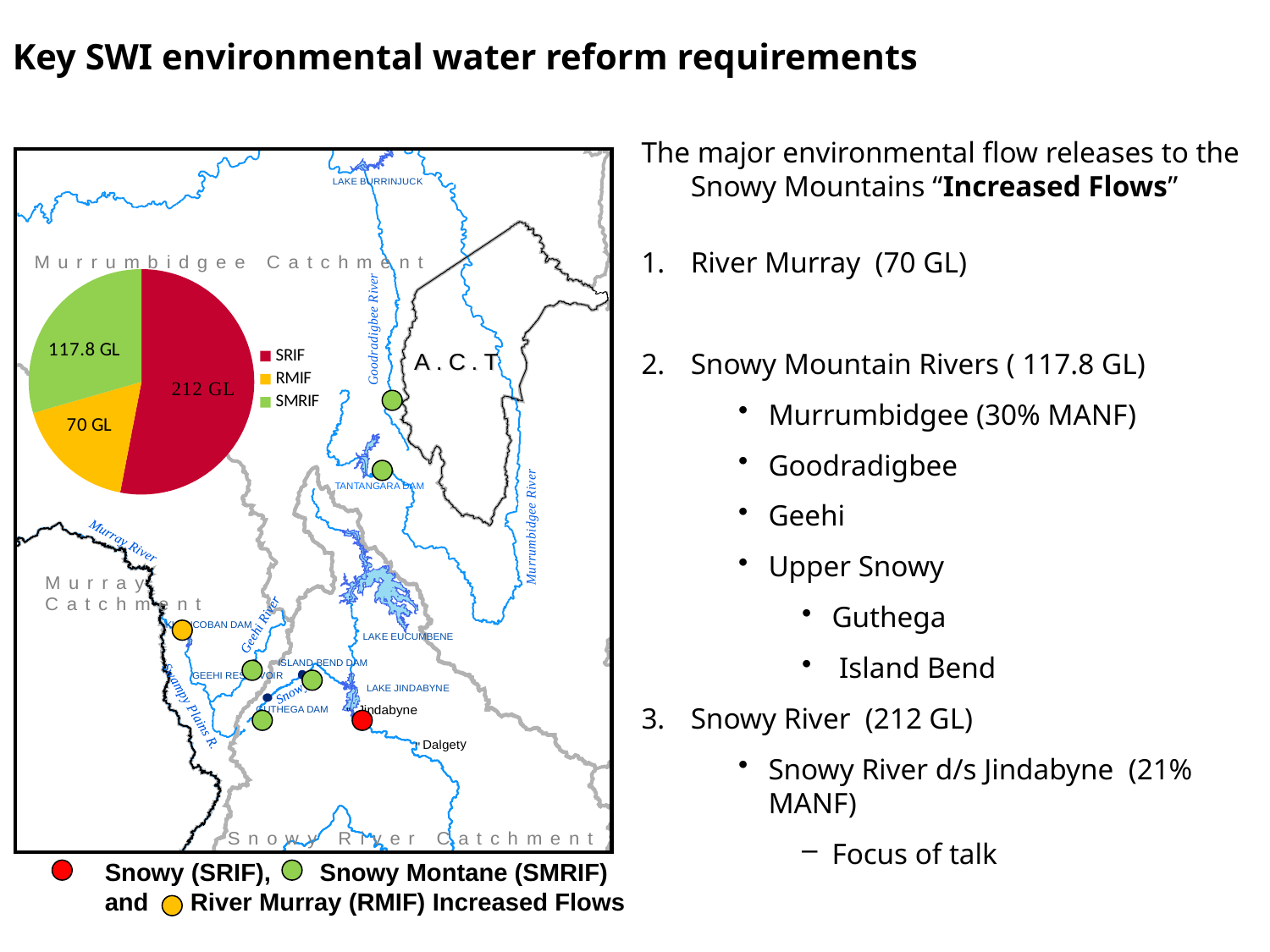
Which is larger in the pie chart, SMRIF or RMIF? SMRIF What is the value for SRIF in the pie chart? 212 GL Which category has the smallest slice in the pie chart? RMIF How many slices does the pie chart have? 3 What is the difference between the SRIF and SMRIF values in the pie chart? 94.2 GL What is the difference between the SMRIF and RMIF values in the pie chart? 47.8 GL Which category has the largest slice in the pie chart? SRIF What is the value for SMRIF in the pie chart? 117.8 GL What colour is the SRIF slice in the pie chart? Red What is the value for RMIF in the pie chart? 70 GL What type of chart is shown on the slide? Pie chart What is the total of all slices in the pie chart? 399.8 GL